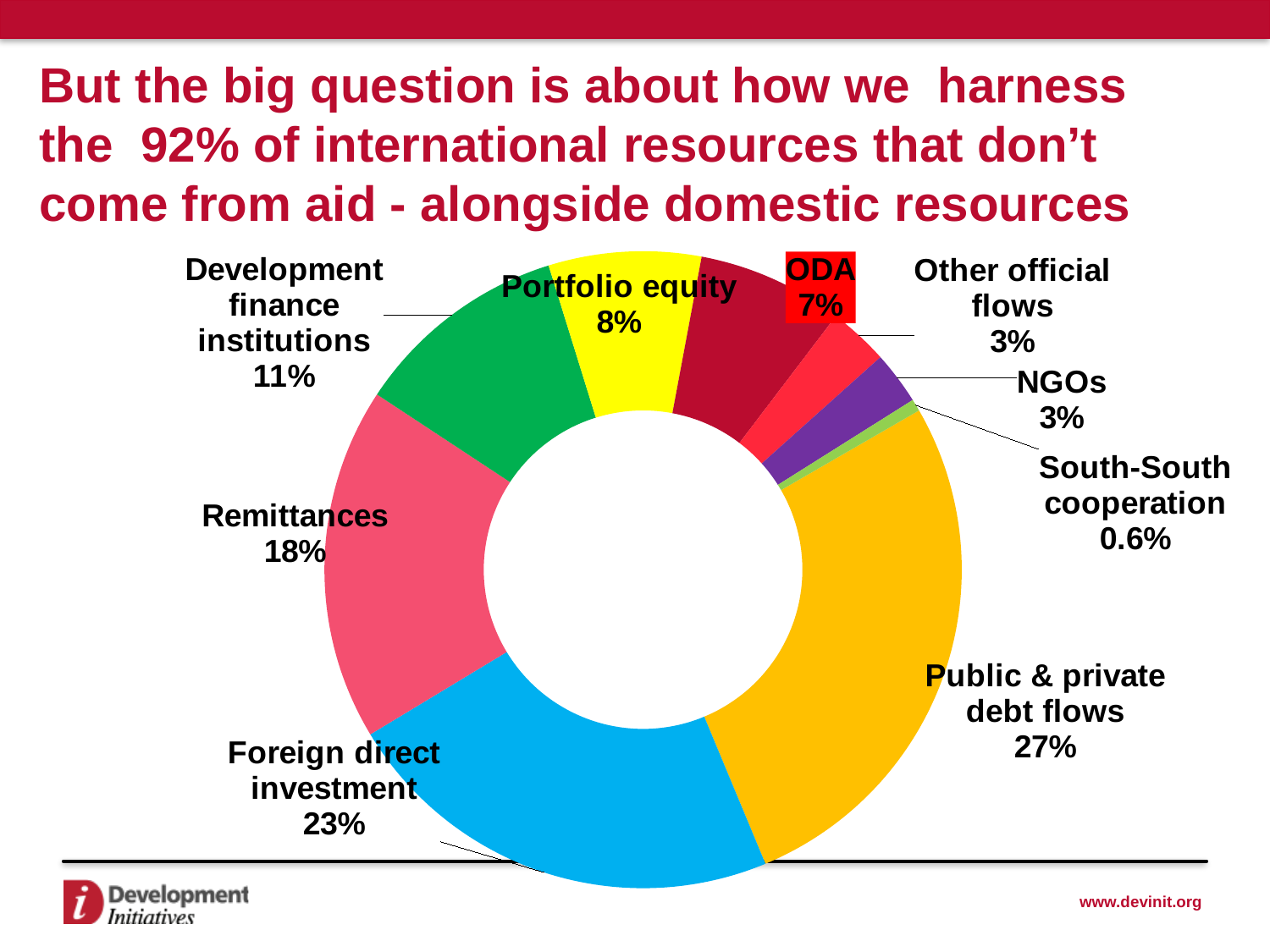
What is the value labelled for ODA? 7% What percentage is shown for South-South cooperation? 0.6% What percentage is shown for Remittances? 18% Which category's label is highlighted with a red box? ODA What is the combined share of Other official flows and NGOs? 6% What is the difference in percentage points between Foreign direct investment and Remittances? 5 Which category has the smallest share of the pie? South-South cooperation Which category has the largest share of the pie? Public & private debt flows What share of the pie does Public & private debt flows account for? 27% What kind of chart is shown on the slide? Pie chart (donut) How many categories are shown in the chart? 9 Which is larger, Development finance institutions or Portfolio equity? Development finance institutions